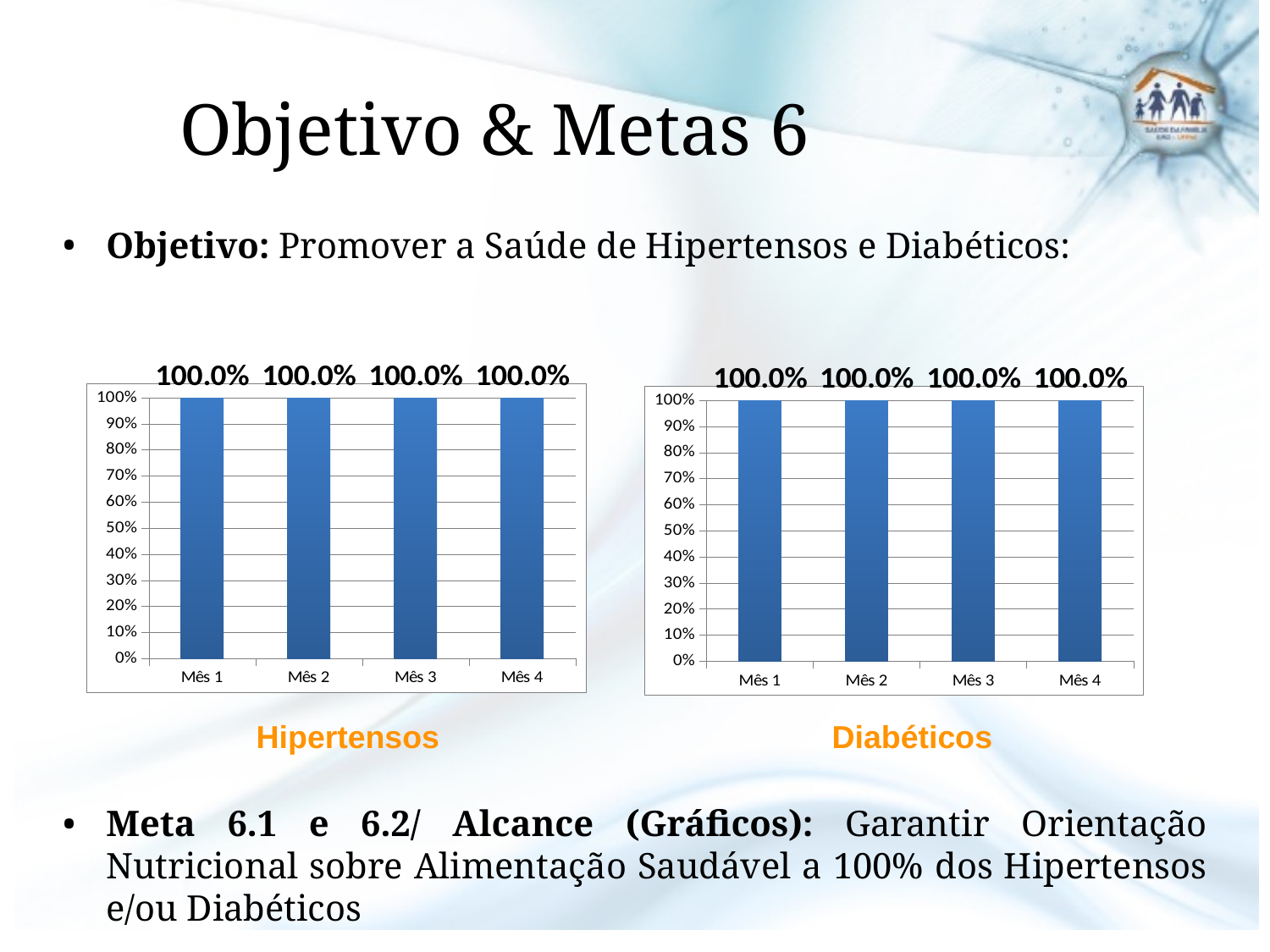
In the Hipertensos chart, do the values rise, fall or stay the same from Mês 1 to Mês 4? Stay the same What is the label printed below the chart on the left? Hipertensos What kind of chart is the Diabéticos chart? Bar chart In the Diabéticos chart, what is the value for Mês 2? 100.0% In the Hipertensos chart, what is the value for Mês 1? 100.0% How many bars does the Diabéticos chart have? 4 What kind of chart is the Hipertensos chart? Bar chart In the Hipertensos chart, what is the value for Mês 3? 100.0% In the Diabéticos chart, do the values rise, fall or stay the same across the months? Stay the same In the Diabéticos chart, what is the difference between the values for Mês 1 and Mês 4? 0.0% How many categories are shown on the x axis of the Hipertensos chart? 4 In the Diabéticos chart, what is the value for Mês 4? 100.0%